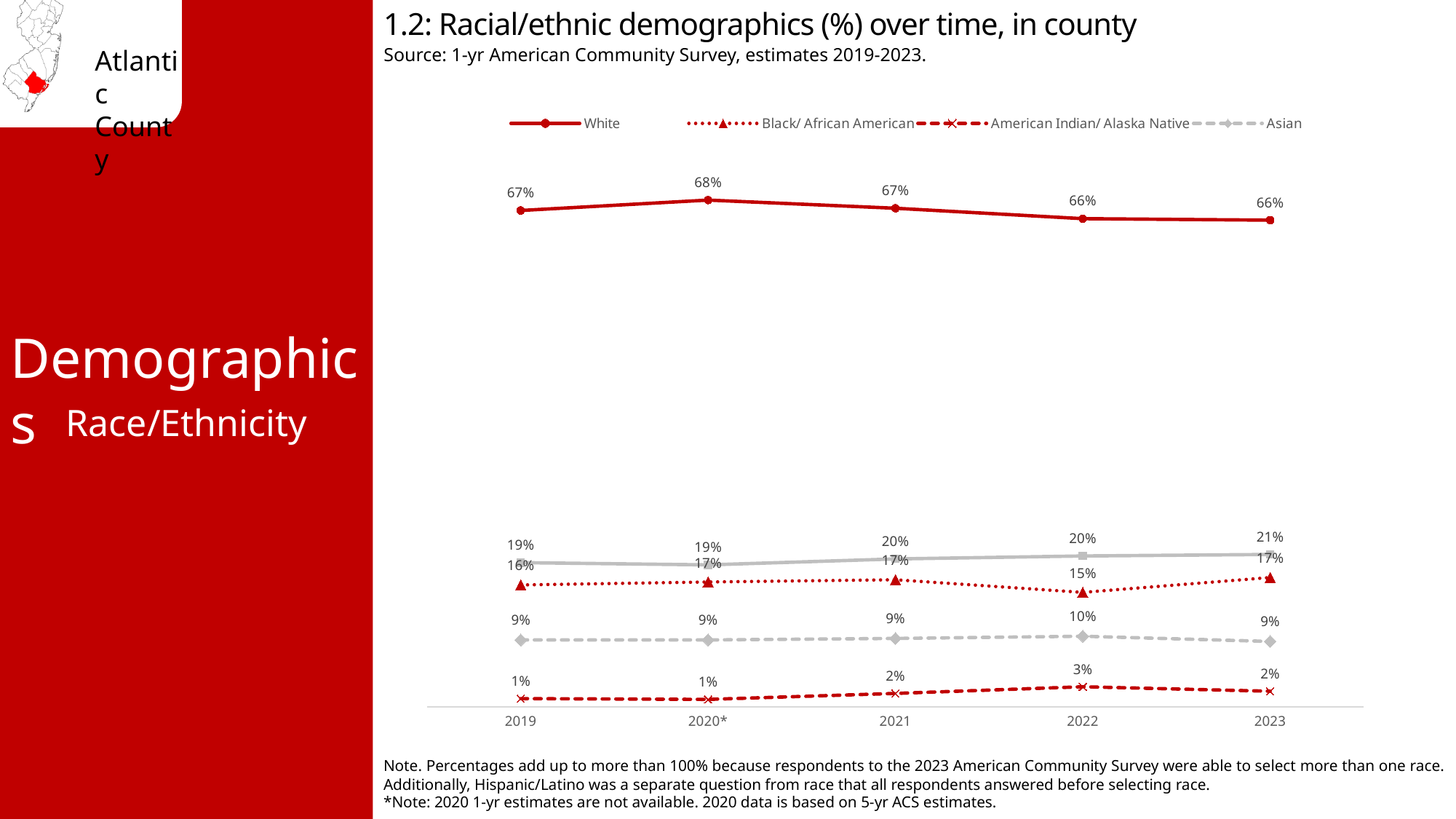
Did the White percentage rise or fall from 2020* to 2023? fall What is the difference between the White percentage in 2019 and in 2023? 1% What type of chart is shown on the slide? line chart In which year was the White percentage highest? 2020* How many years are shown on the x axis? 5 What was the American Indian/ Alaska Native percentage in 2022? 3% How many series are listed in the legend? 4 In which year was the Black/ African American percentage lowest? 2022 What was the Asian percentage in 2022? 10% What was the Black/ African American percentage in 2022? 15% What was the White percentage in 2020*? 68% Which was larger in 2021, the Black/ African American percentage or the Asian percentage? Black/ African American